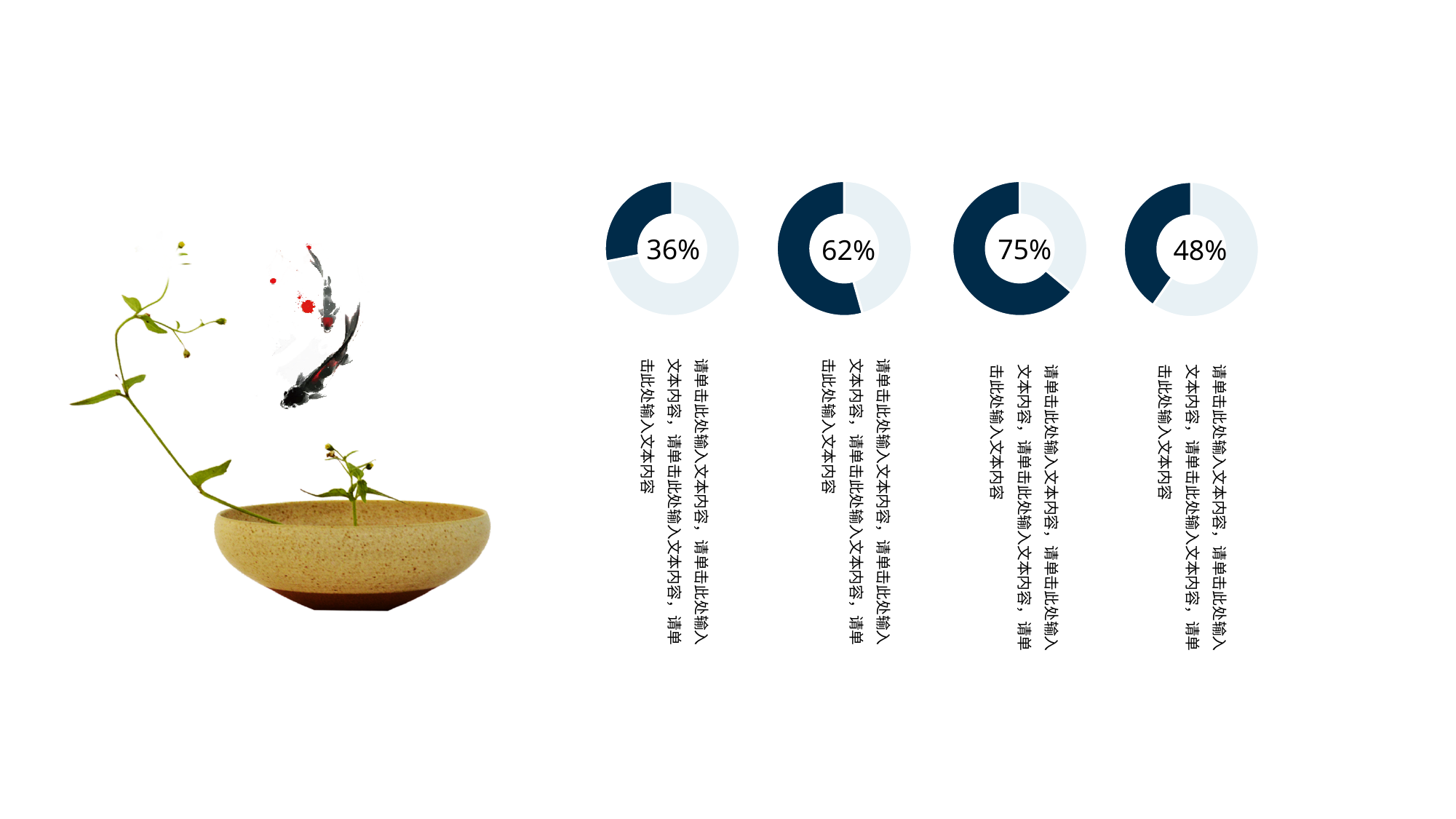
Which is larger: the percentage in the second donut chart or the percentage in the rightmost donut chart? The second donut chart (62%) What kind of chart is used to display the four percentages on the slide? Donut chart What colour is the filled portion of each donut chart? Dark navy blue What percentage is shown in the center of the second donut chart from the left? 62% What percentage is shown in the center of the third donut chart from the left? 75% What percentage is shown in the center of the leftmost donut chart? 36% Which of the four donut charts shows the highest percentage? The third from the left (75%) What is the difference between the percentage in the third donut chart (75%) and the percentage in the leftmost donut chart (36%)? 39% Which of the four donut charts shows the lowest percentage? The leftmost (36%) What is the difference between the percentage in the second donut chart (62%) and the percentage in the rightmost donut chart (48%)? 14% How many donut charts are shown on the slide? 4 What percentage is shown in the center of the rightmost donut chart? 48%